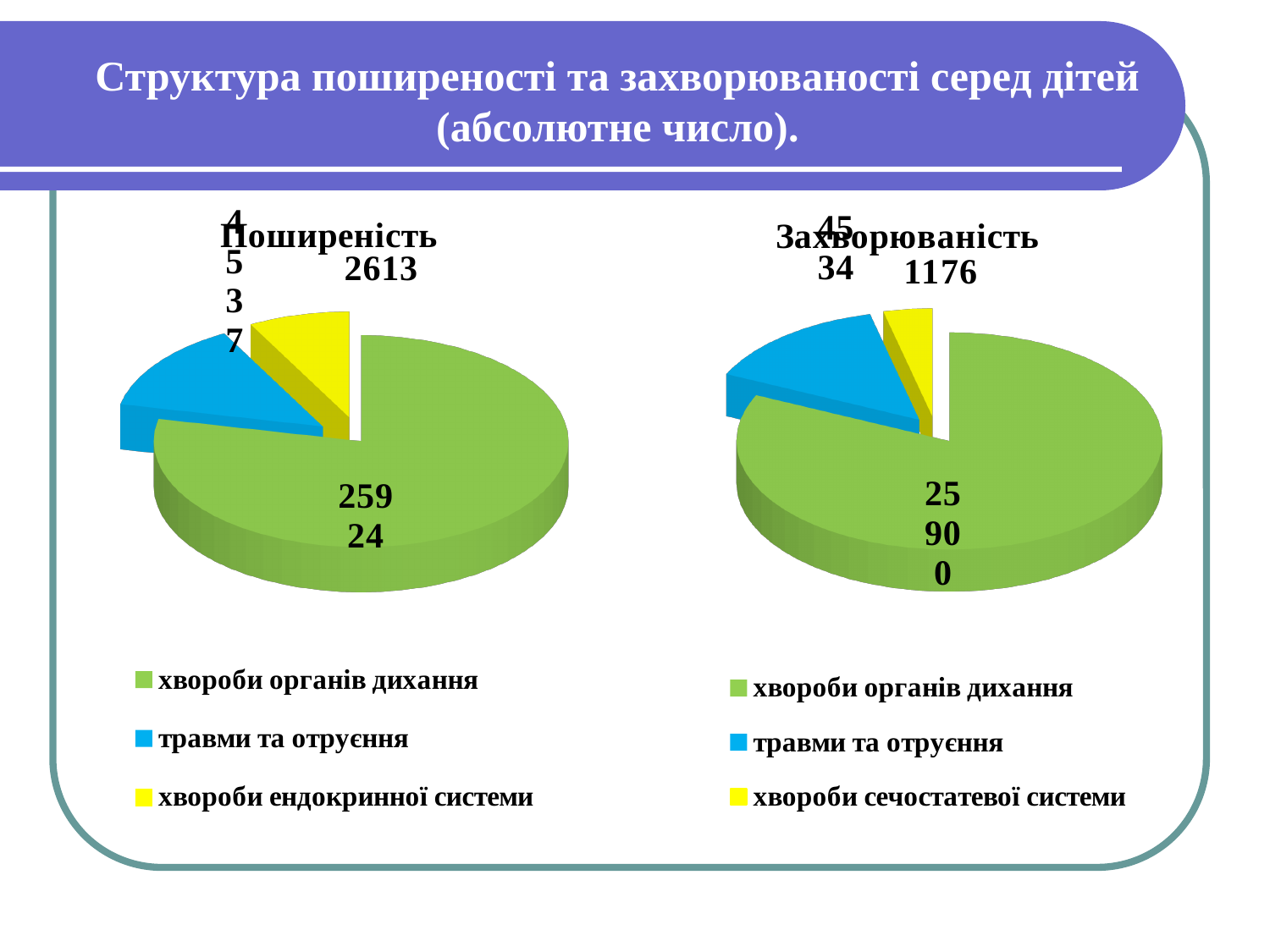
What type of chart is used on this slide? pie chart In the Поширеність chart, what is the value for хвороби ендокринної системи? 2613 In the Захворюваність chart, what is the value for хвороби органів дихання? 25900 In the Поширеність chart, what is the difference between хвороби органів дихання and хвороби ендокринної системи? 23311 In the Захворюваність chart, what colour is the slice for травми та отруєння? blue How many categories does the legend of the Поширеність chart list? 3 In the Захворюваність chart, what is the value for хвороби сечостатевої системи? 1176 In the Поширеність chart, which category has the largest slice? хвороби органів дихання In the Захворюваність chart, what is the value for травми та отруєння? 4534 In the Захворюваність chart, which is larger: травми та отруєння or хвороби сечостатевої системи? травми та отруєння In the Поширеність chart, what is the value for хвороби органів дихання? 25924 In the Захворюваність chart, which category has the smallest slice? хвороби сечостатевої системи